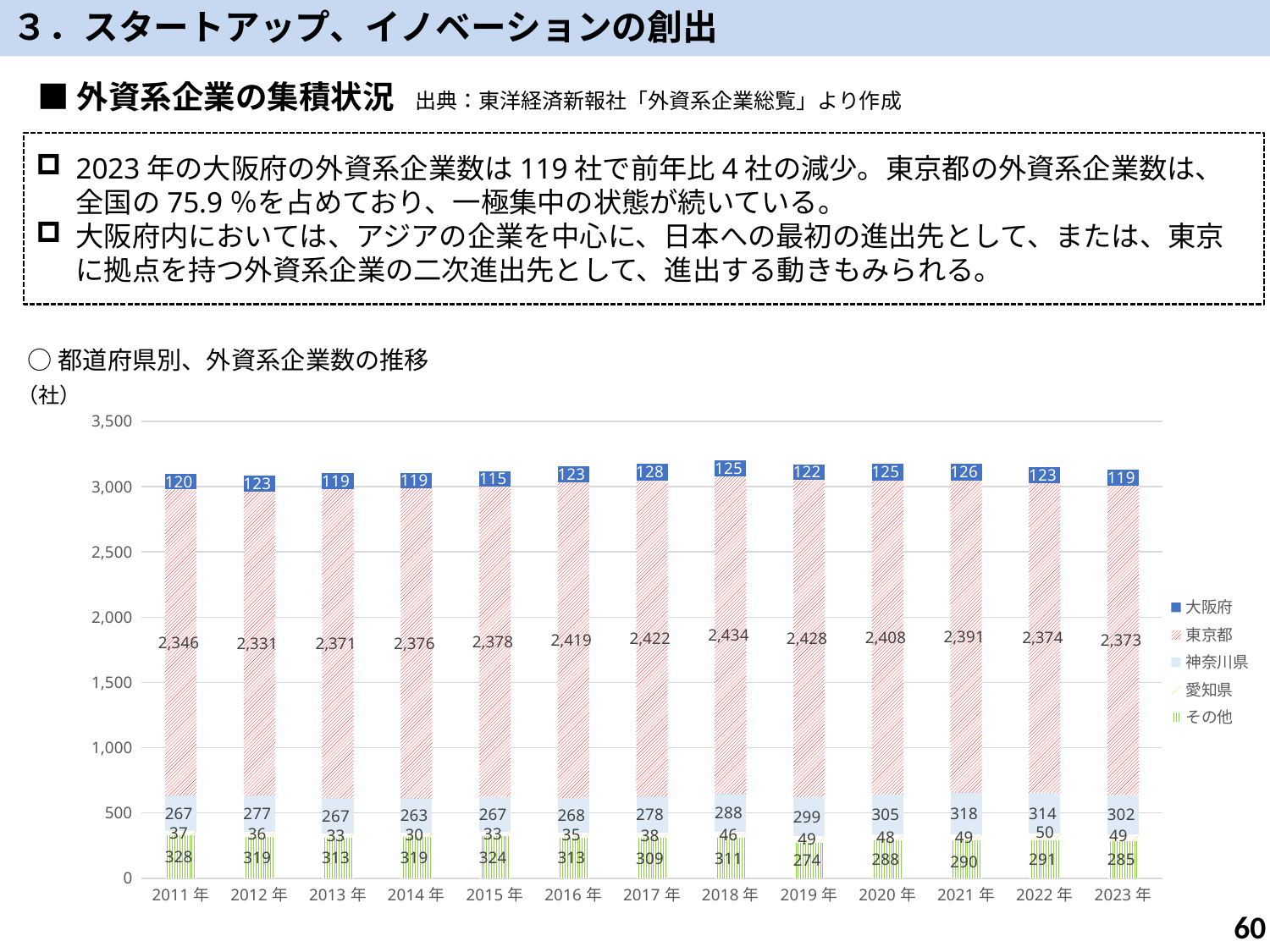
In which year is the value for 東京都 highest? 2018 年 What is the difference between the 大阪府 values for 2022 年 and 2023 年? 4 Which is larger, the その他 value in 2011 年 or in 2023 年? 2011 年 What is the value for 大阪府 in 2015 年? 115 What is the value for 神奈川県 in 2021 年? 318 In which year is the value for 大阪府 lowest? 2015 年 What is the value for 東京都 in 2023 年? 2,373 How many series does the legend list? 5 What unit is shown above the y axis of the chart? 社 How many years are shown on the x axis? 13 What kind of chart is shown? stacked bar chart What is the total of the stacked bar for 2023 年? 3,128